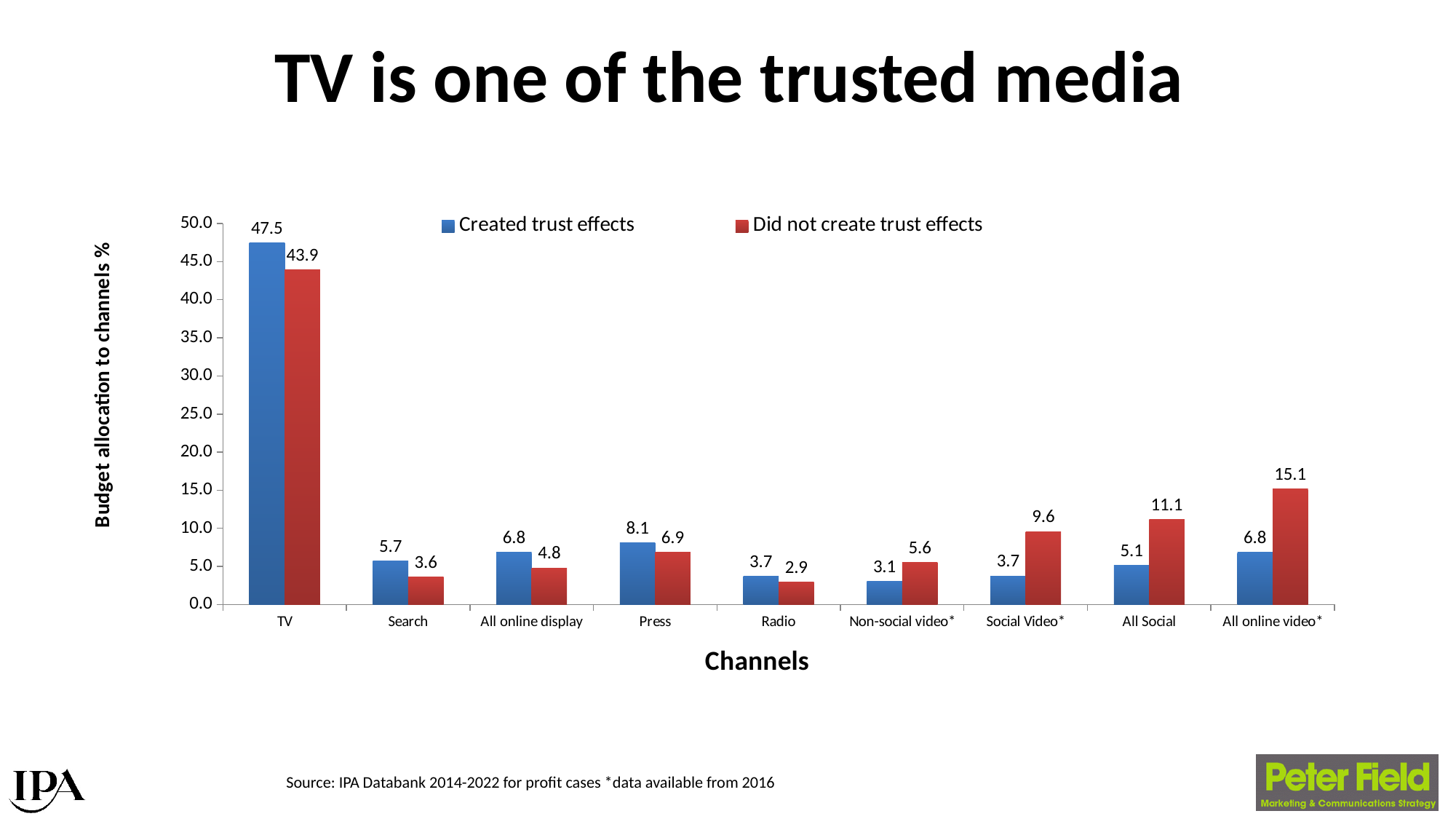
Is the 'Did not create trust effects' value for All Social greater or less than 10.0? greater How many channels are shown on the x axis? 9 What is the value for Press in the 'Created trust effects' series? 8.1 What is the difference between the 'Created trust effects' and 'Did not create trust effects' values for TV? 3.6 What is the value for All online video* in the 'Did not create trust effects' series? 15.1 Which channel has the highest value in the 'Did not create trust effects' series? TV What kind of chart is shown on the slide? Bar chart How many series does the legend list? 2 What is the label of the y axis? Budget allocation to channels % Which channel has the lowest value in the 'Created trust effects' series? Non-social video* For Social Video*, which series has the larger value: 'Created trust effects' or 'Did not create trust effects'? Did not create trust effects What is the value for TV in the 'Created trust effects' series? 47.5